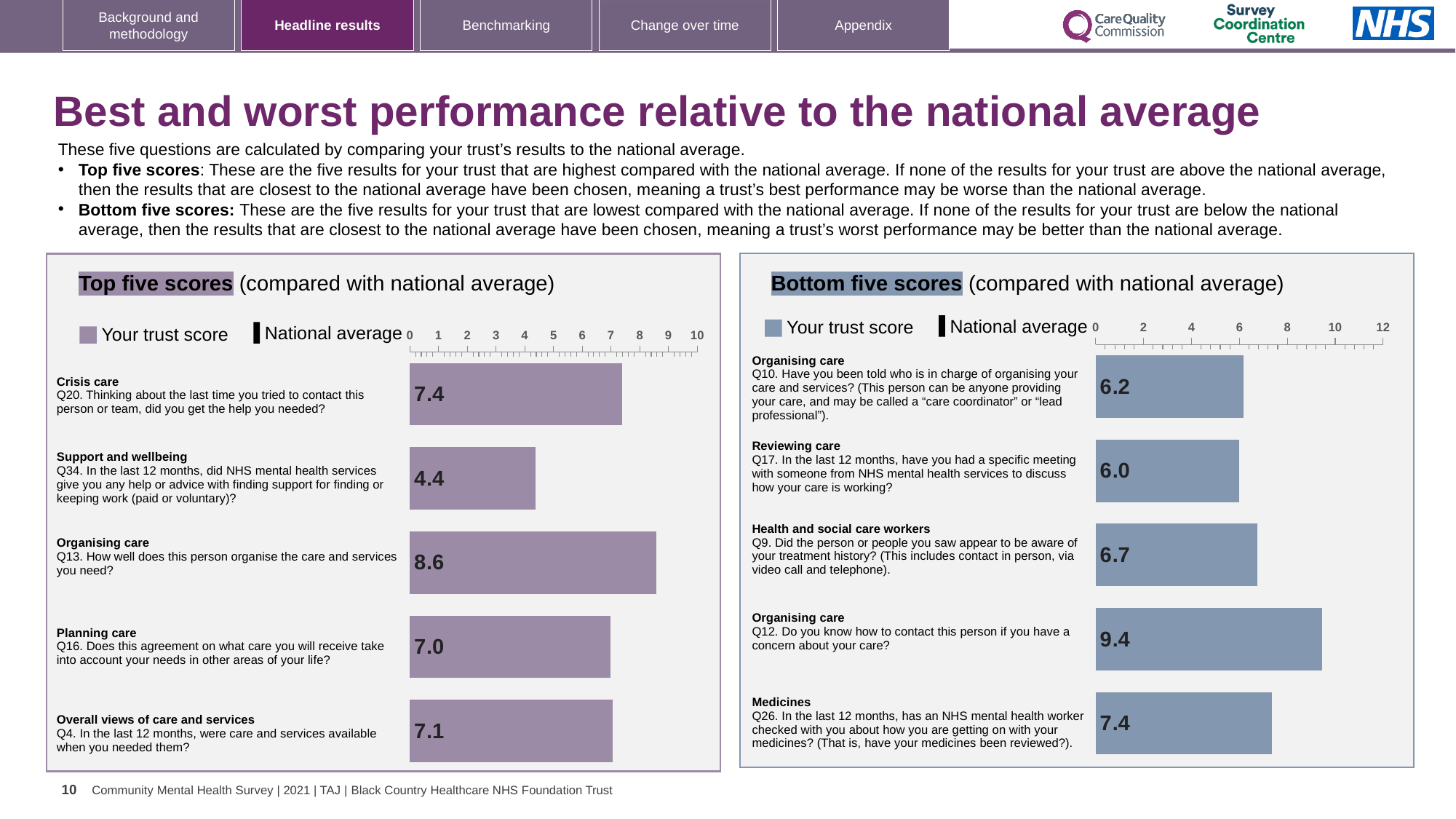
In the 'Bottom five scores' chart, which category has the lowest trust score? Reviewing care (Q17) In the 'Top five scores' chart, which category has the lowest trust score? Support and wellbeing (Q34) In the 'Top five scores' chart, what is the trust score for Support and wellbeing (Q34)? 4.4 In the 'Bottom five scores' chart, what is the trust score for Reviewing care (Q17)? 6.0 In the 'Bottom five scores' chart, what is the trust score for Medicines (Q26)? 7.4 In the 'Top five scores' chart, what is the trust score for Crisis care (Q20)? 7.4 In the 'Top five scores' chart, what is the difference between the trust scores for Organising care (Q13) and Planning care (Q16)? 1.6 How many categories are plotted in the 'Bottom five scores' chart? 5 In the 'Bottom five scores' chart, which category has the highest trust score? Organising care (Q12) What kind of chart is the 'Top five scores' chart? Bar chart In the 'Top five scores' chart, which category has the highest trust score? Organising care (Q13) In the 'Bottom five scores' chart, which has the larger trust score: Health and social care workers (Q9) or Organising care (Q10)? Health and social care workers (Q9)